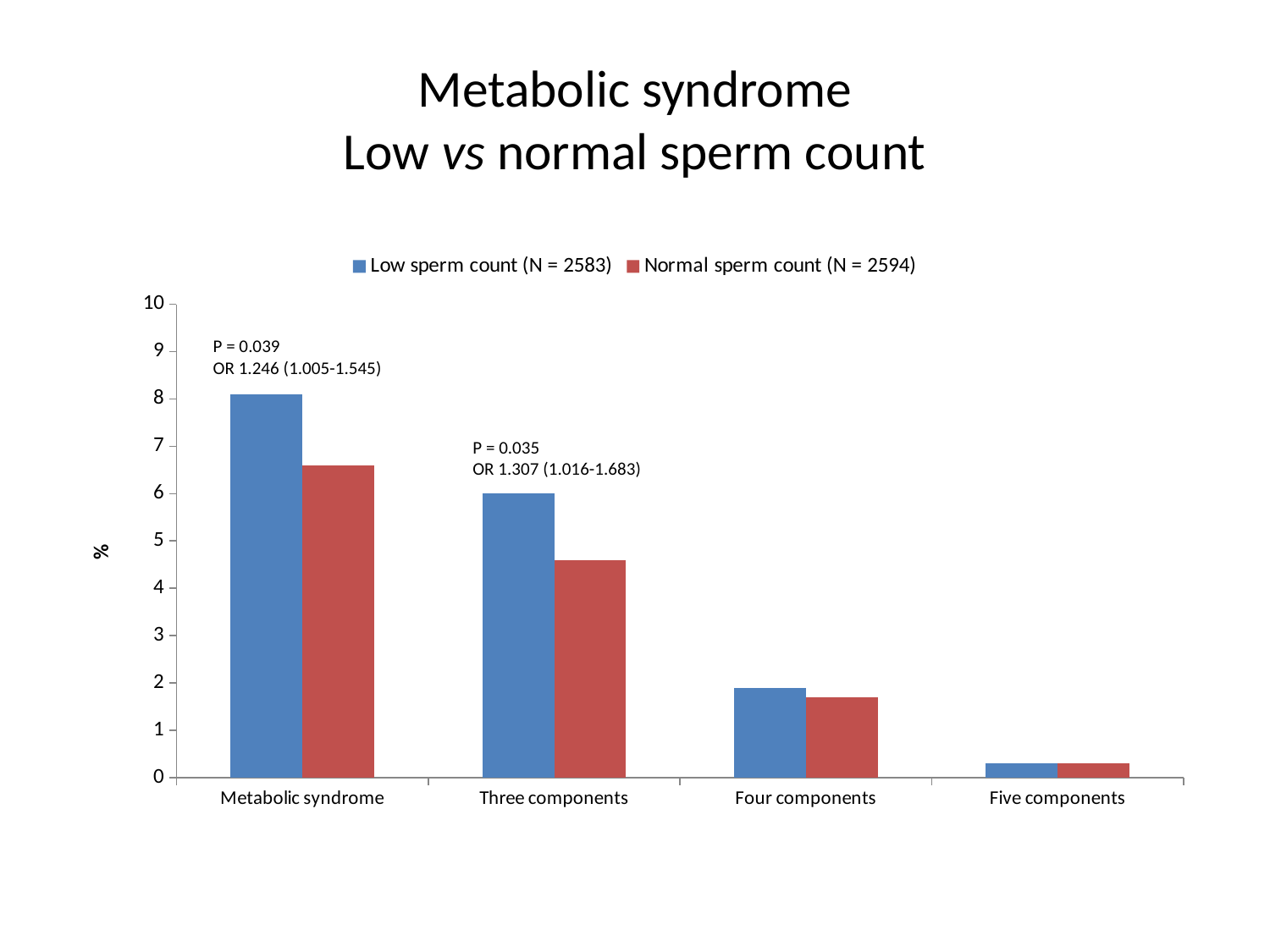
Is the Normal sperm count value for Three components greater or less than 5? less For Metabolic syndrome, which series has the larger value, Low sperm count or Normal sperm count? Low sperm count How many series does the legend list? 2 What is the P value shown above the Metabolic syndrome bars? P = 0.039 Which category has the lowest value for Normal sperm count? Five components Which category has the highest value for Low sperm count? Metabolic syndrome What kind of chart is shown on the slide? bar chart Is the Normal sperm count value for Metabolic syndrome greater or less than 7? less Do the Low sperm count values rise or fall from Metabolic syndrome to Five components along the x axis? fall How many categories are shown on the x axis? 4